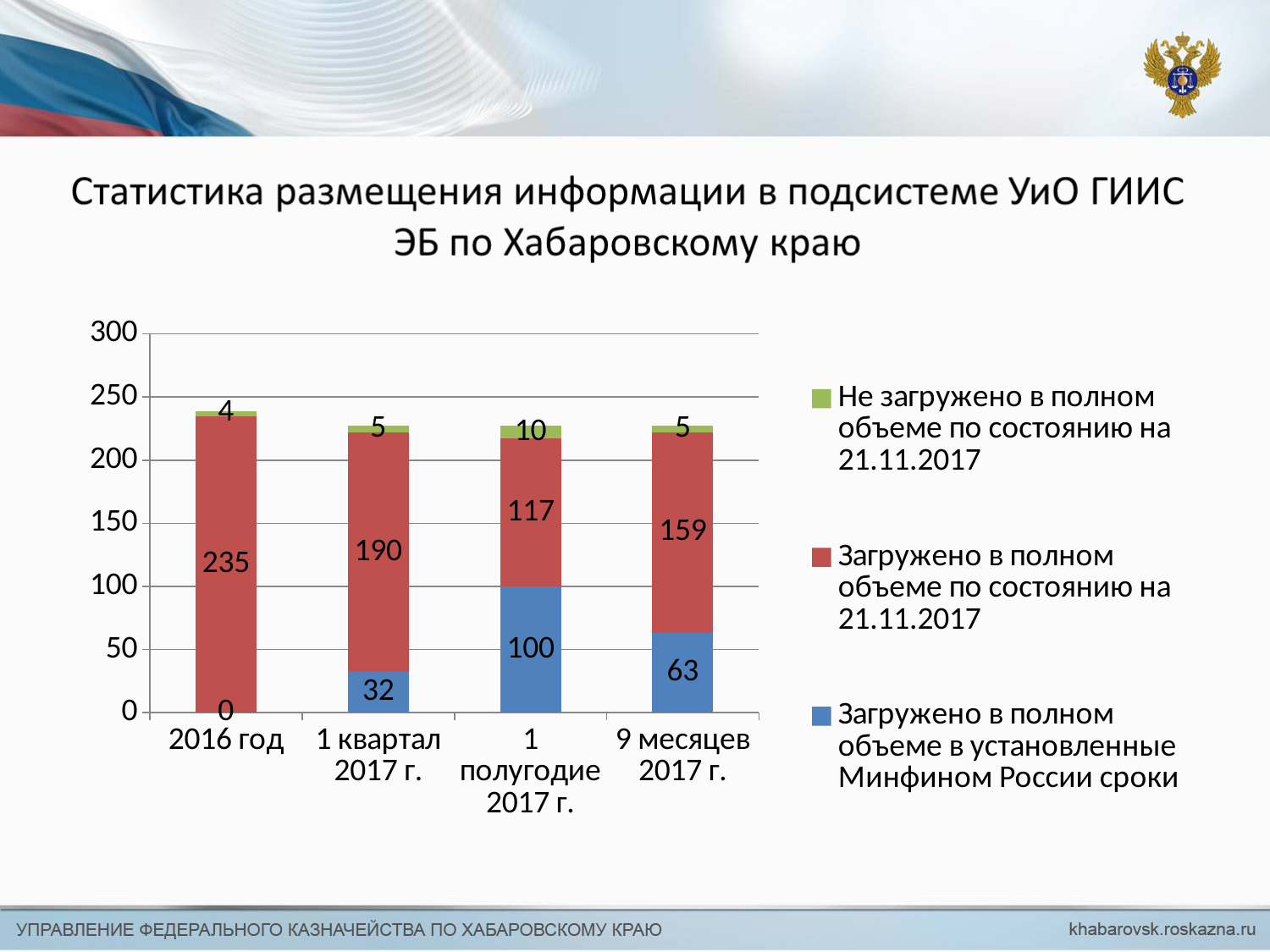
Which category has the lowest value for 'Загружено в полном объеме по состоянию на 21.11.2017'? 1 полугодие 2017 г. What is the value of 'Загружено в полном объеме в установленные Минфином России сроки' for 1 полугодие 2017 г.? 100 What is the difference between the 'Загружено в полном объеме по состоянию на 21.11.2017' values for 1 квартал 2017 г. and 9 месяцев 2017 г.? 31 What is the total of the stacked bar for 2016 год? 239 What kind of chart is shown on the slide? Stacked bar chart How many series does the chart legend list? 3 What is the value of 'Загружено в полном объеме по состоянию на 21.11.2017' for 2016 год? 235 Which category has the highest value for 'Загружено в полном объеме в установленные Минфином России сроки'? 1 полугодие 2017 г. What is the value of 'Загружено в полном объеме в установленные Минфином России сроки' for 9 месяцев 2017 г.? 63 Which colour represents 'Не загружено в полном объеме по состоянию на 21.11.2017' in the chart? Green How many categories are shown on the x axis of the chart? 4 What is the value of 'Не загружено в полном объеме по состоянию на 21.11.2017' for 1 полугодие 2017 г.? 10